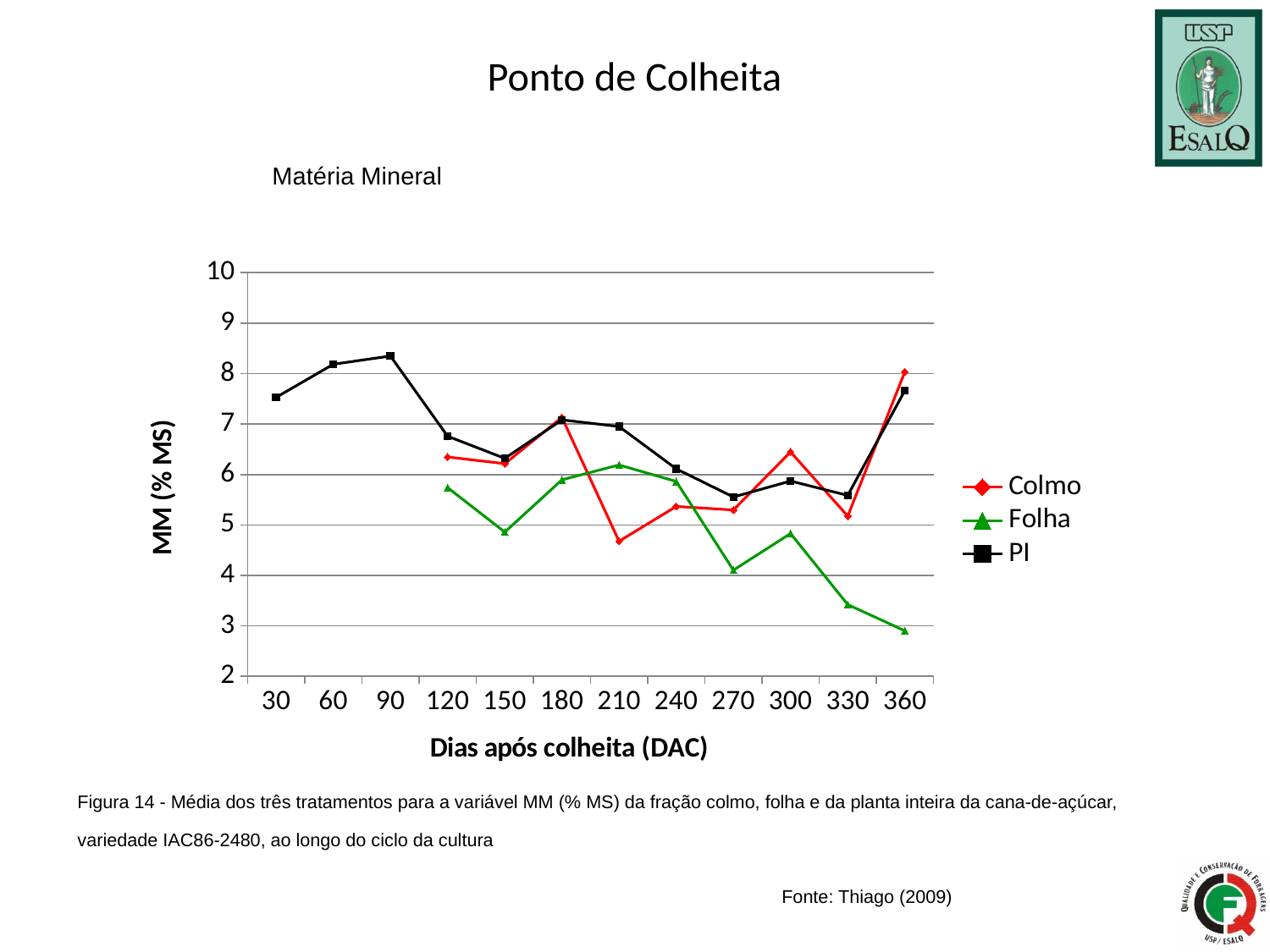
What kind of chart is shown on the slide? line chart At 210 DAC, which is larger, Colmo or Folha? Folha How many series does the legend list? 3 Is the value for PI at 90 DAC greater or less than 8? greater How many DAC points are shown on the x axis? 12 What is the title of the y axis? MM (% MS) At which DAC does the Colmo series reach its highest value? 360 Is the value for Folha at 360 DAC greater or less than 3? less Is the value for Colmo at 210 DAC greater or less than 5? less At which DAC does the PI series reach its highest value? 90 Does the Folha series rise or fall overall from 210 DAC to 360 DAC? fall At which DAC does the Folha series reach its lowest value? 360